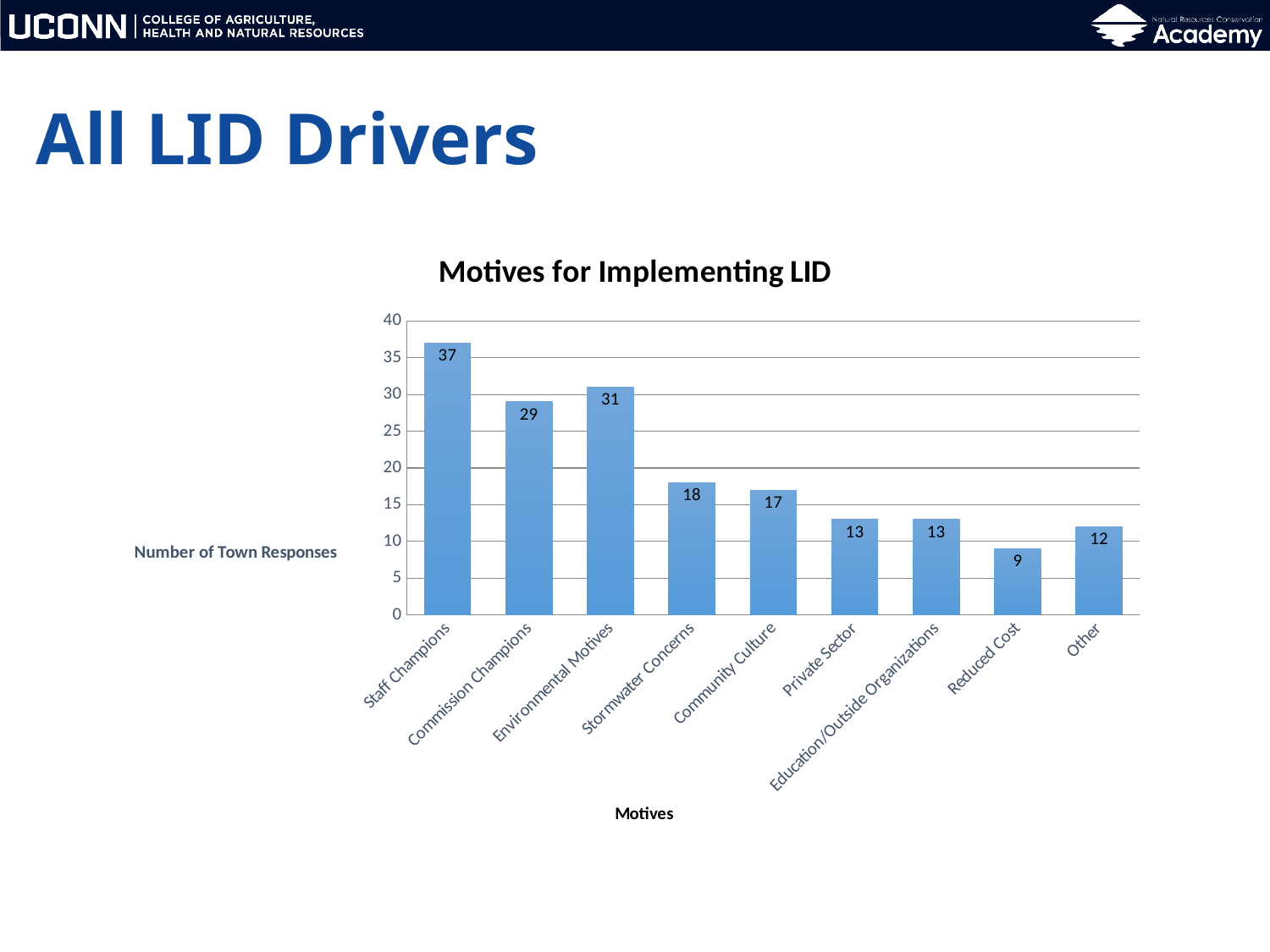
What is the number of town responses for Staff Champions? 37 What is the difference in town responses between Staff Champions and Commission Champions? 8 What kind of chart is shown on the slide? Bar chart Which has more town responses, Environmental Motives or Commission Champions? Environmental Motives What is the label of the vertical axis? Number of Town Responses Which motive has the highest number of town responses? Staff Champions What is the number of town responses for Reduced Cost? 9 What is the number of town responses for Stormwater Concerns? 18 Is the value for Community Culture greater or less than 20? less How many motive categories are shown on the x axis? 9 What is the title of the chart? Motives for Implementing LID Which motive has the lowest number of town responses? Reduced Cost